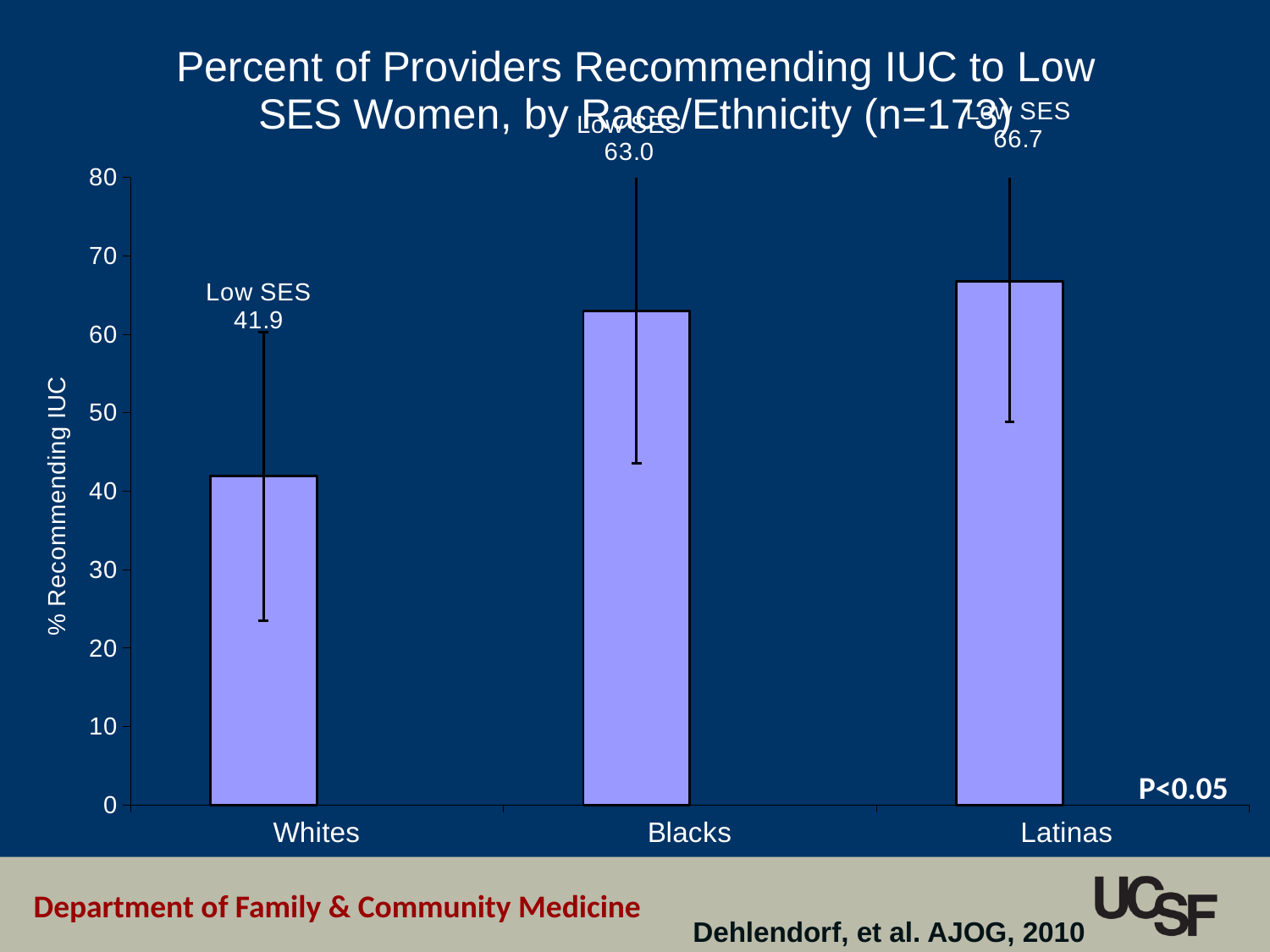
Which category has the lowest value? Whites What kind of chart is this? bar chart What is the difference between the values for Blacks and Whites? 21.1 Which is larger, the value for Whites or the value for Blacks? Blacks What is the difference between the values for Latinas and Whites? 24.8 How many categories are shown on the x axis? 3 What is the value for Latinas? 66.7 What is the value for Blacks? 63.0 What is the label of the y axis? % Recommending IUC What is the value for Whites? 41.9 Is the value for Whites greater or less than 50? less Which category has the highest value? Latinas